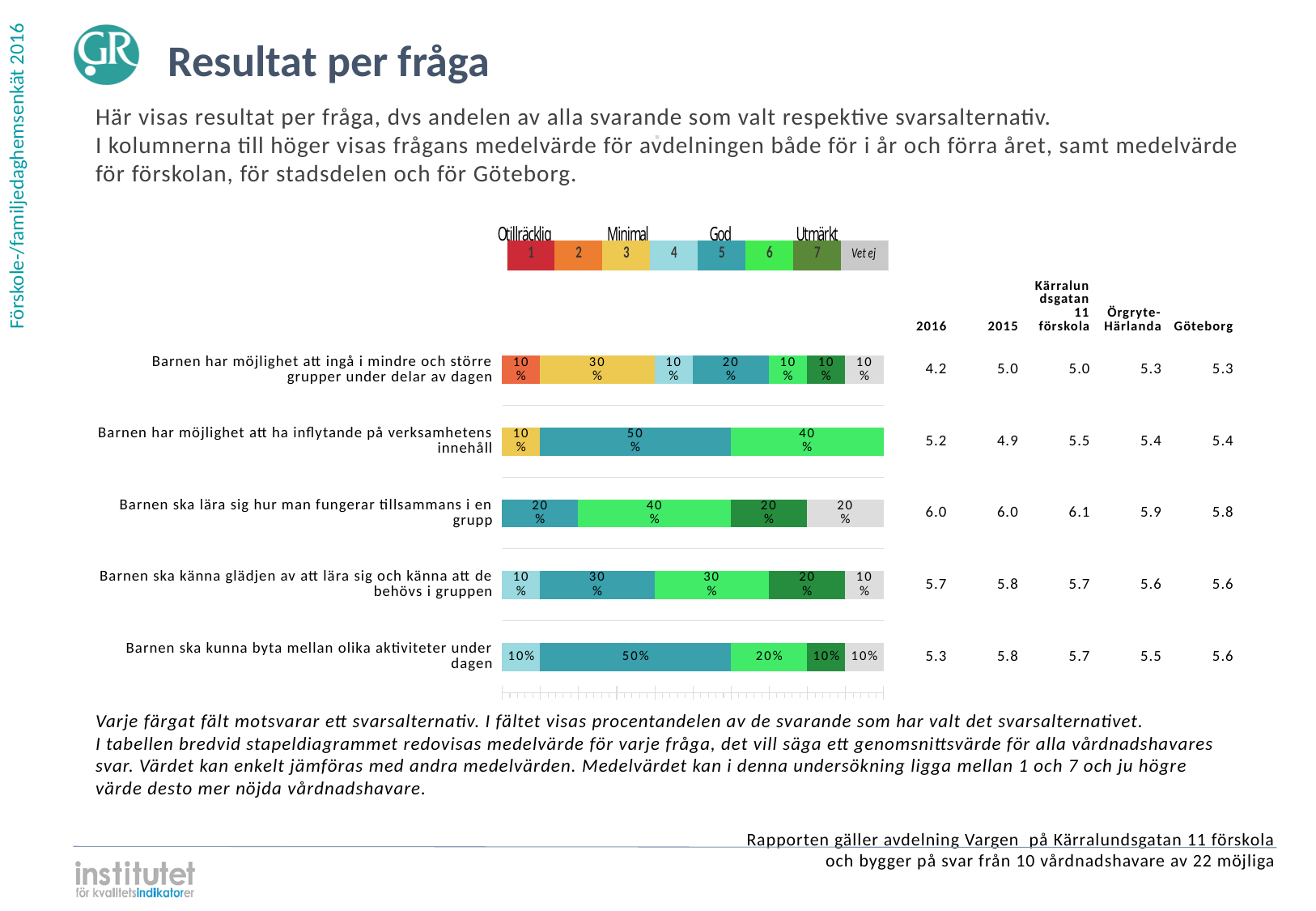
How many answer categories does the legend above the chart list? 8 What percentage chose answer option 6 (light green) for 'Barnen ska lära sig hur man fungerar tillsammans i en grupp'? 40% What percentage answered 'Vet ej' for 'Barnen ska kunna byta mellan olika aktiviteter under dagen'? 10% Which question has the lowest 2016 mean value in the table? Barnen har möjlighet att ingå i mindre och större grupper under delar av dagen What percentage of respondents chose answer option 5 (God, teal) for 'Barnen har möjlighet att ha inflytande på verksamhetens innehåll'? 50% For 'Barnen ska känna glädjen av att lära sig och känna att de behövs i gruppen', what is the difference between the share for option 5 and the share for option 7? 10% For 'Barnen har möjlighet att ha inflytande på verksamhetens innehåll', which is larger: the share for option 5 or the share for option 6? Option 5 What is the 2016 mean value for 'Barnen ska lära sig hur man fungerar tillsammans i en grupp'? 6.0 What percentage chose answer option 3 (yellow) for 'Barnen har möjlighet att ingå i mindre och större grupper under delar av dagen'? 30% What kind of chart is used to show the results per question? Stacked bar chart Which answer option has the largest share for 'Barnen ska kunna byta mellan olika aktiviteter under dagen'? 5 (God) How many questions (bars) are shown in the chart? 5